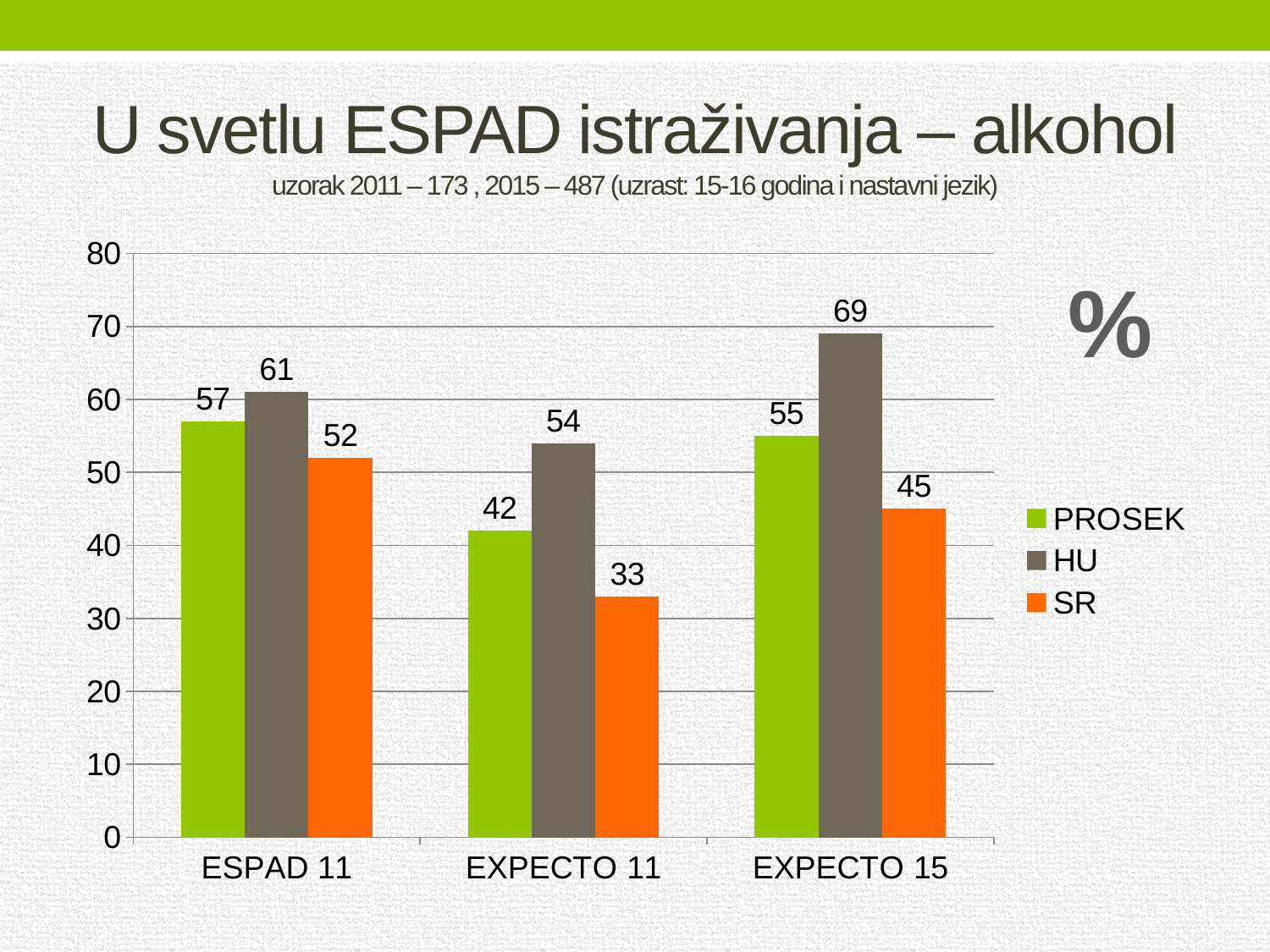
Which is larger: the PROSEK value for ESPAD 11 or the PROSEK value for EXPECTO 15? ESPAD 11 What is the value for SR in the EXPECTO 11 category? 33 What is the value for HU in the EXPECTO 15 category? 69 What is the value for PROSEK in the ESPAD 11 category? 57 Which category has the highest HU value? EXPECTO 15 Which category has the lowest SR value? EXPECTO 11 Which series is shown in orange? SR What kind of chart is shown on the slide? bar chart How many categories are shown on the x axis? 3 How many series does the legend list? 3 What is the difference between the HU and SR values in the EXPECTO 15 category? 24 What is the difference between the HU and PROSEK values in the EXPECTO 11 category? 12